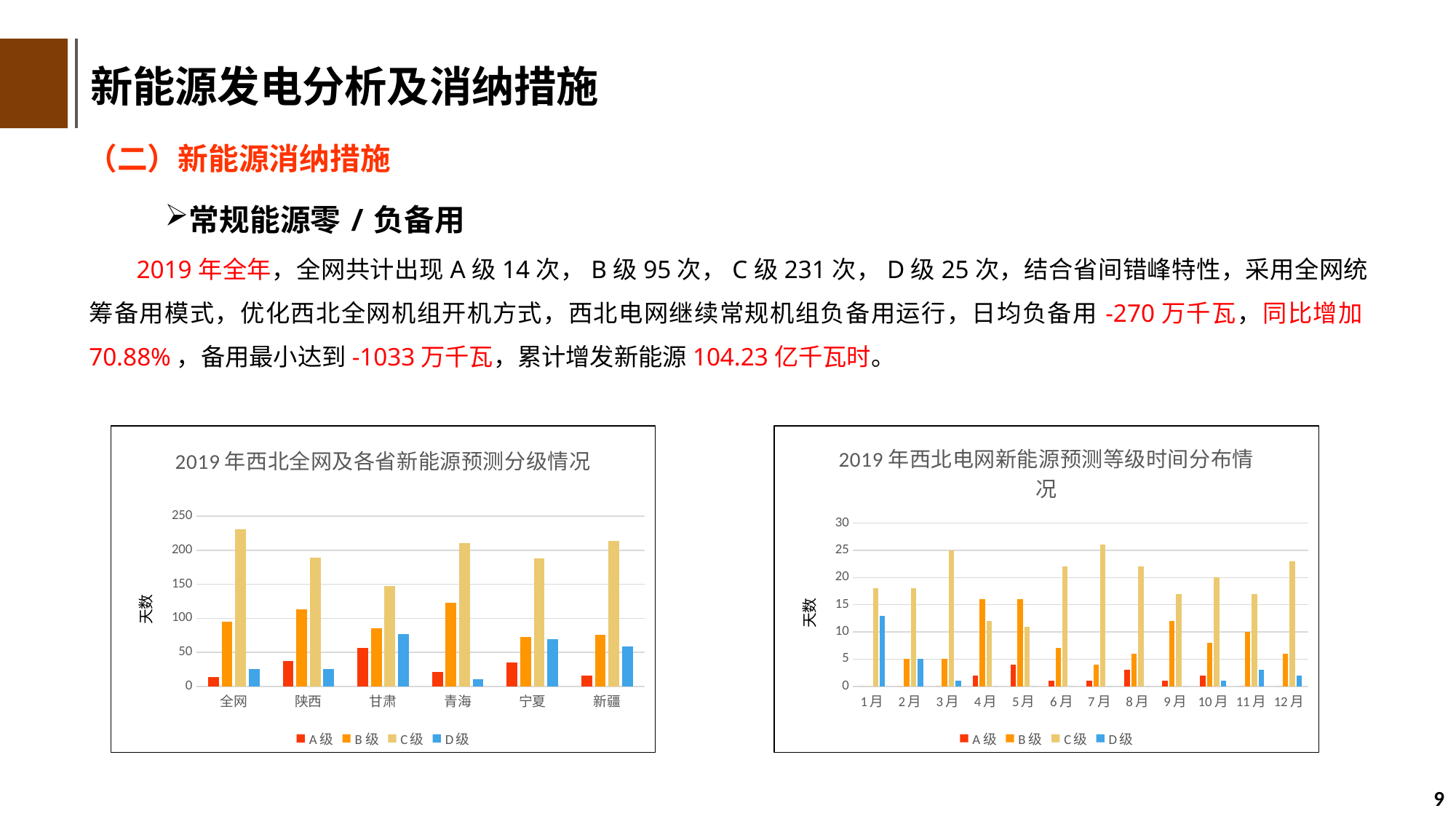
In the left chart (2019年西北全网及各省新能源预测分级情况), which is larger: the B级 value for 青海 or the B级 value for 新疆? 青海 What is the y-axis label of the left chart (2019年西北全网及各省新能源预测分级情况)? 天数 In the right chart (2019年西北电网新能源预测等级时间分布情况), which month has the highest D级 value? 1月 How many months are shown on the x axis of the right chart (2019年西北电网新能源预测等级时间分布情况)? 12 In the right chart (2019年西北电网新能源预测等级时间分布情况), which is larger: the C级 value for 1月 or the C级 value for 3月? 3月 In the left chart (2019年西北全网及各省新能源预测分级情况), which category has the lowest C级 value? 甘肃 How many series does the legend of the left chart (2019年西北全网及各省新能源预测分级情况) list? 4 What type of chart is the left chart titled 2019年西北全网及各省新能源预测分级情况? bar chart How many categories are shown on the x axis of the left chart (2019年西北全网及各省新能源预测分级情况)? 6 In the left chart (2019年西北全网及各省新能源预测分级情况), is the C级 value for 全网 greater or less than 200? greater In the left chart (2019年西北全网及各省新能源预测分级情况), which series has the highest value for 全网? C级 In the right chart (2019年西北电网新能源预测等级时间分布情况), is the D级 value for 1月 greater or less than 10? greater